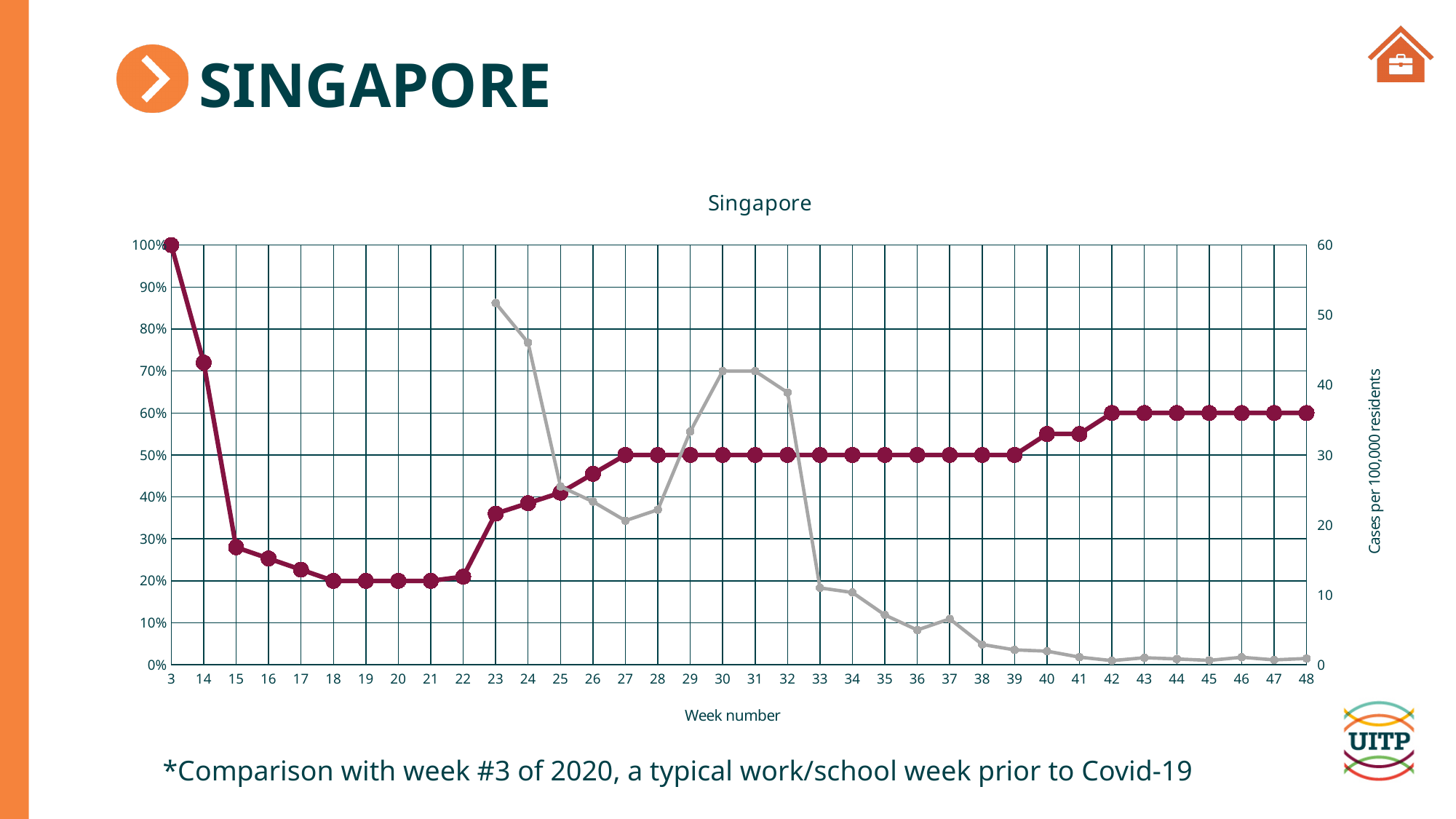
What is the value of the maroon line at week 3? 100% What is the title of the right-hand vertical axis? Cases per 100,000 residents At which week number does the maroon line reach its highest value? 3 What is the value of the maroon line at week 20? 20% Is the maroon line's value at week 26 greater or less than 50%? less What is the value of the maroon line at week 45? 60% What is the difference between the maroon line's value at week 3 and at week 20? 80 percentage points How many week numbers are shown on the x axis? 36 What is the value of the maroon line at week 30? 50% Does the maroon line rise or fall between week 3 and week 18? fall Is the grey line's value at week 36 greater or less than 10 on the right-hand axis? less What kind of chart is shown on the slide? line chart